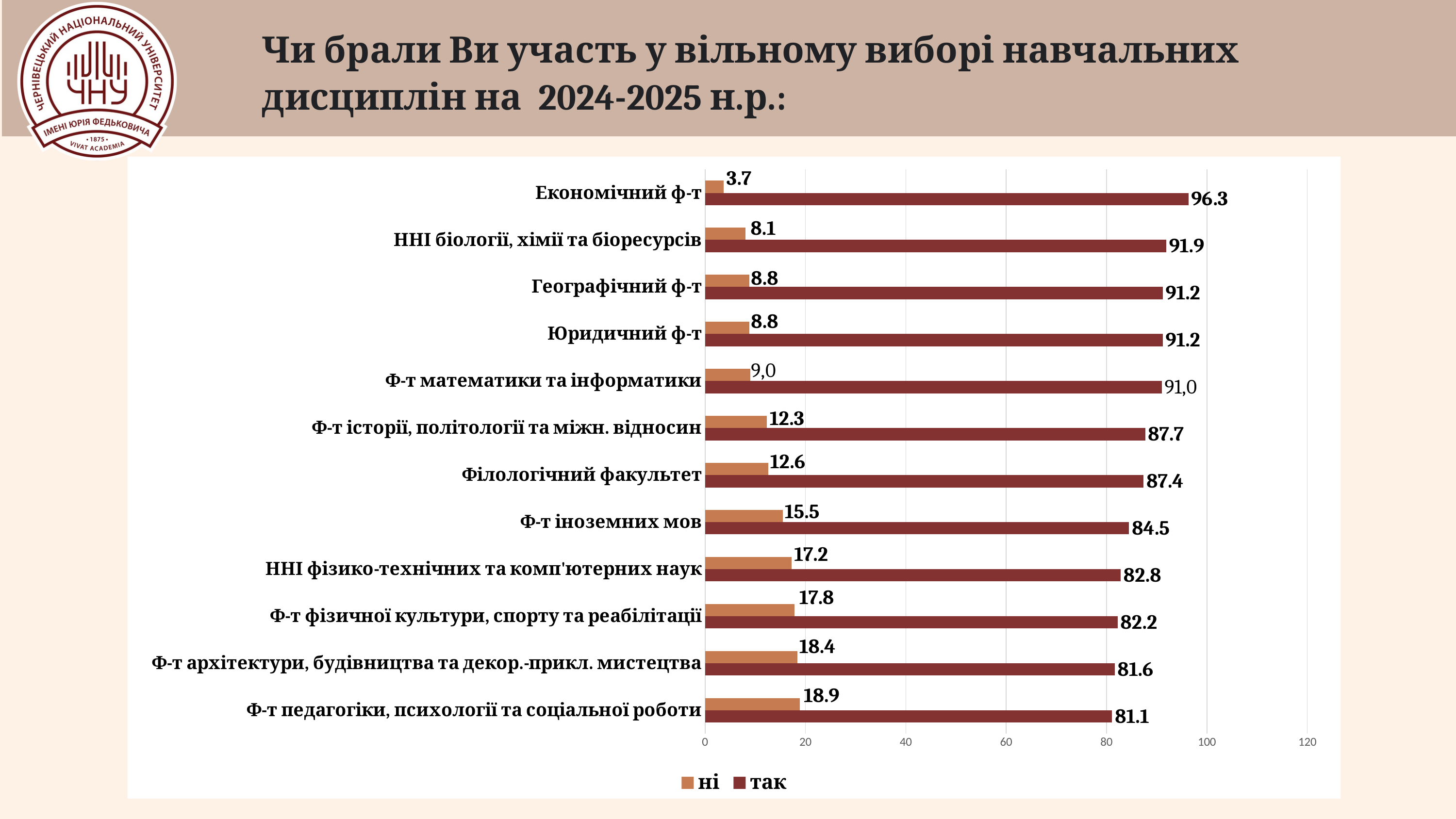
How many categories (faculties) are shown on the chart? 12 Which category has the lowest value in the "ні" series? Економічний ф-т Which category has the highest value in the "ні" series? Ф-т педагогіки, психології та соціальної роботи Which category has the highest value in the "так" series? Економічний ф-т How many series does the legend list? 2 What is the value of the "так" series for Ф-т математики та інформатики? 91,0 Which is larger: the "ні" value for Філологічний факультет or for Ф-т іноземних мов? Ф-т іноземних мов Is the "так" value for ННІ фізико-технічних та комп'ютерних наук greater or less than 80? greater What kind of chart is shown on the slide? Bar chart What is the difference between the "так" values for Економічний ф-т and Ф-т педагогіки, психології та соціальної роботи? 15.2 What is the value of the "ні" series for Ф-т іноземних мов? 15.5 What is the value of the "так" series for Економічний ф-т? 96.3